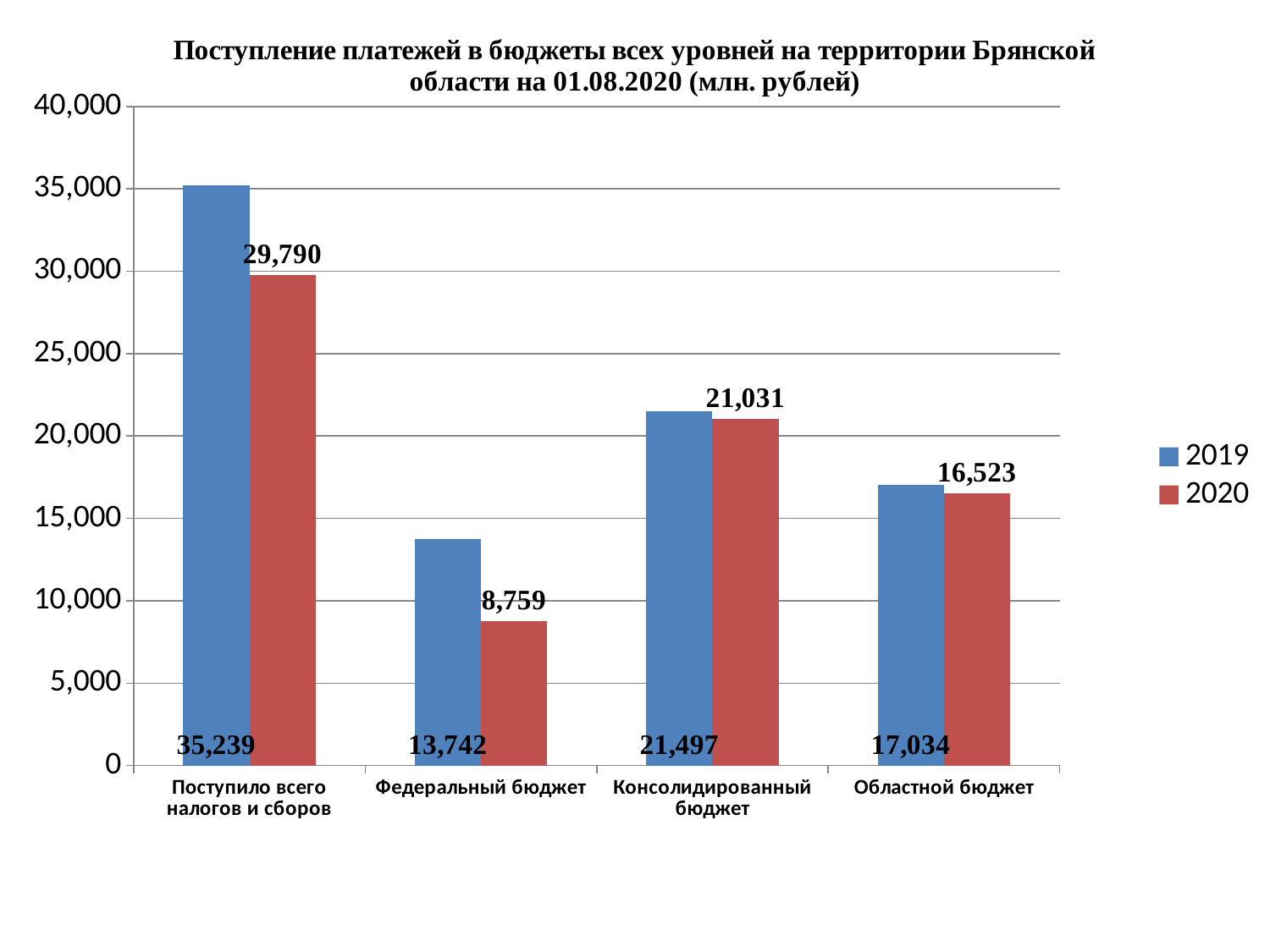
What is the 2019 value for Областной бюджет? 17,034 Which category has the lowest 2020 value? Федеральный бюджет What is the difference between the 2019 and 2020 values for Поступило всего налогов и сборов? 5,449 What is the 2020 value for Федеральный бюджет? 8,759 What is the 2019 value for Поступило всего налогов и сборов? 35,239 What kind of chart is shown on the slide? Bar chart Which is larger for Областной бюджет, the 2019 value or the 2020 value? 2019 How many series does the legend list? 2 What is the difference between the 2019 and 2020 values for Федеральный бюджет? 4,983 How many categories are shown on the x axis? 4 Which category has the highest 2019 value? Поступило всего налогов и сборов What is the 2020 value for Консолидированный бюджет? 21,031